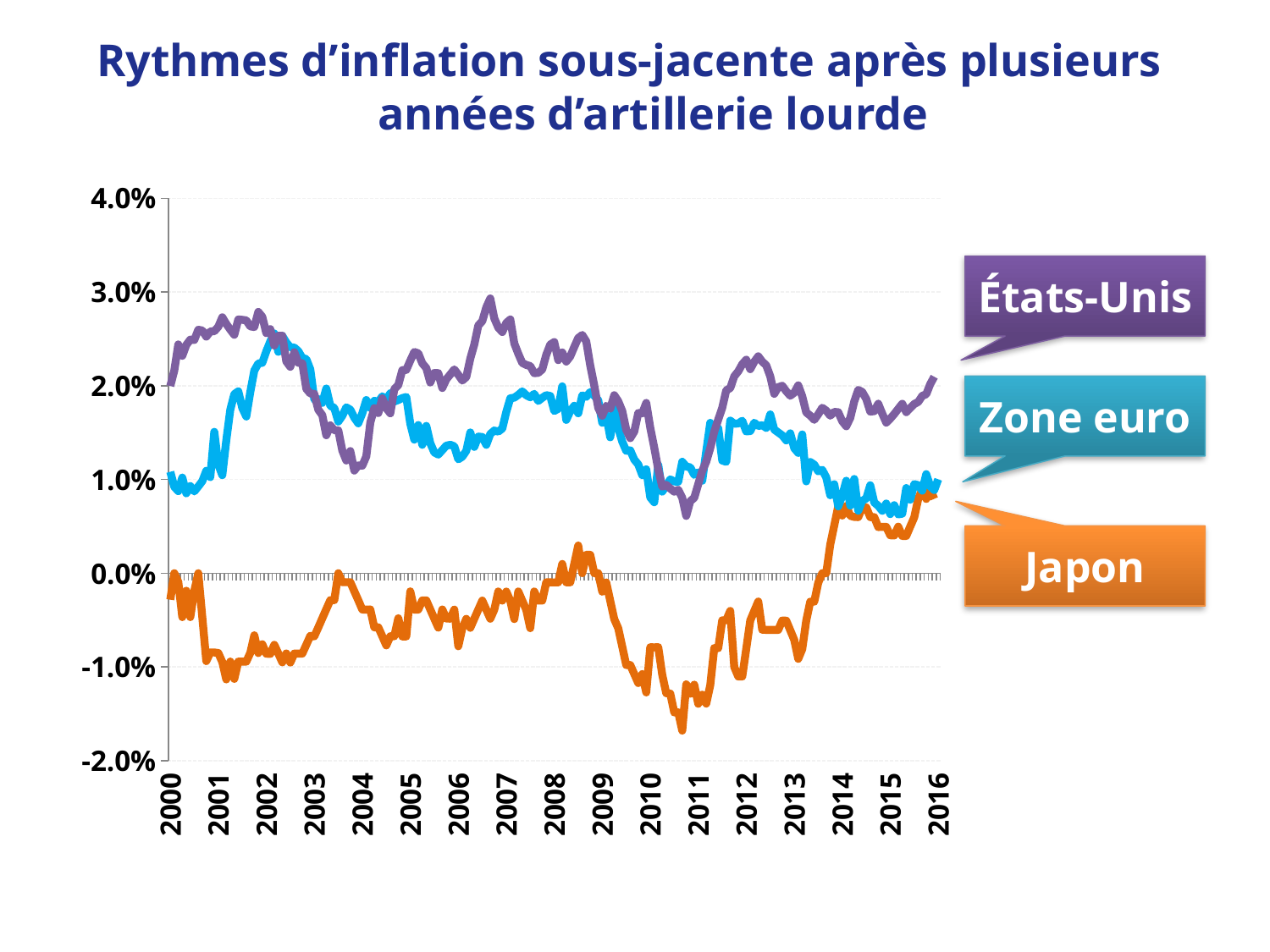
How many series are labelled on the chart? 3 What colour is the Japon line? orange Is the value for États-Unis in 2001 greater or less than 2.0%? greater How many year labels are shown on the x axis? 17 In 2010, which series has the higher value, Zone euro or Japon? Zone euro Which series reaches the lowest value on the chart? Japon Does the Japon line rise or fall between 2013 and 2014? rise Which series reaches the highest value on the chart? États-Unis Is the value for Japon in late 2010 greater or less than -1.0%? less Is the value for Zone euro in 2015 greater or less than 1.0%? less What kind of chart is shown on the slide? line chart